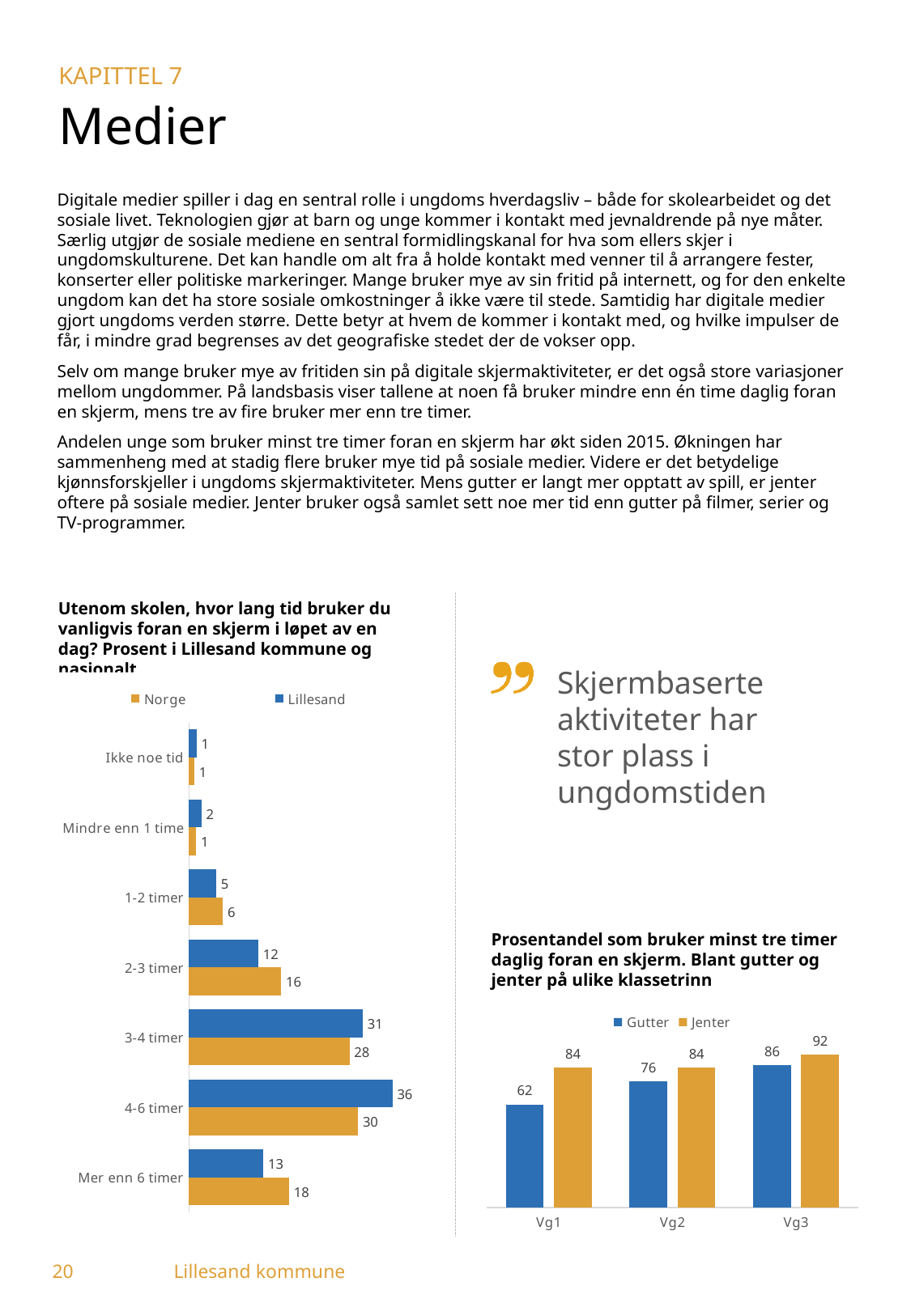
What kind of chart is the left chart (screen time per day)? Bar chart In the right chart (Prosentandel som bruker minst tre timer daglig foran en skjerm), do the Gutter values rise or fall from Vg1 to Vg3? Rise In the left chart (screen time per day), which is larger for '3-4 timer': the Norge value or the Lillesand value? Lillesand In the left chart (screen time per day), what is the Norge value for '2-3 timer'? 16 In the left chart (screen time per day), how many series does the legend list? 2 In the right chart (Prosentandel som bruker minst tre timer daglig foran en skjerm), which class level has the highest Jenter value? Vg3 In the left chart (screen time per day), what is the difference between the Norge and Lillesand values for 'Mer enn 6 timer'? 5 In the left chart (screen time per day), how many categories are shown? 7 In the left chart (screen time per day), what is the Lillesand value for '4-6 timer'? 36 In the left chart (screen time per day), which category has the highest Lillesand value? 4-6 timer In the right chart (Prosentandel som bruker minst tre timer daglig foran en skjerm), what is the Gutter value for Vg1? 62 In the right chart (Prosentandel som bruker minst tre timer daglig foran en skjerm), what is the difference between Jenter and Gutter for Vg1? 22